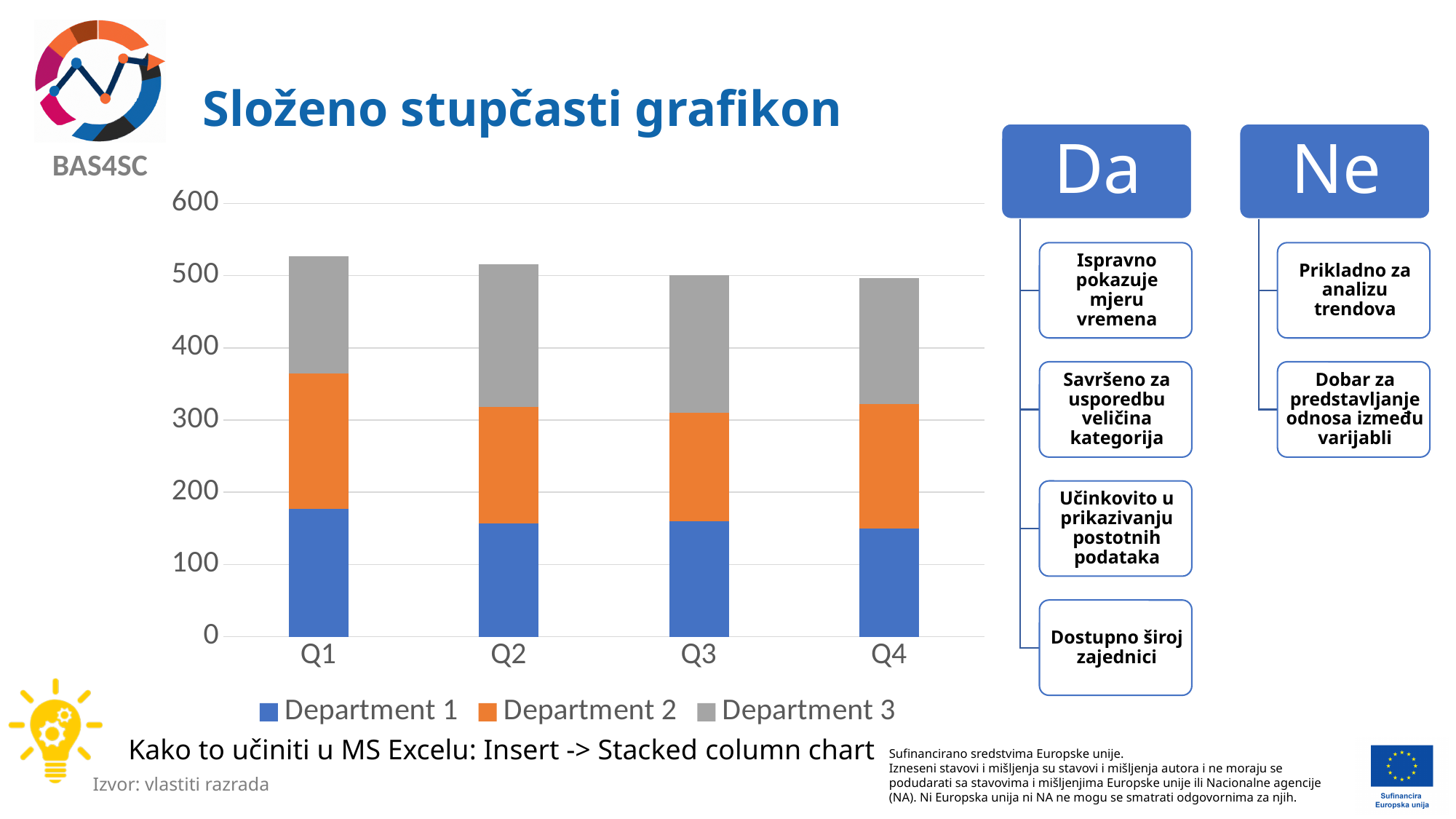
What is the title of the slide containing the chart? Složeno stupčasti grafikon Which quarter has the tallest stacked bar overall? Q1 Is the total of the stacked bar for Q1 greater or less than 600? less Do the total bar heights generally rise or fall from Q1 to Q4? fall Which is larger: the Department 1 value in Q1 or the Department 1 value in Q4? Q1 How many categories are shown on the x axis of the chart? 4 What kind of chart is shown on the slide? Stacked bar chart How many series does the chart legend list? 3 Which colour represents Department 3 in the chart legend? Grey Is the value for Department 1 in Q1 greater or less than 200? less Is the value for Department 1 in Q4 greater or less than 100? greater